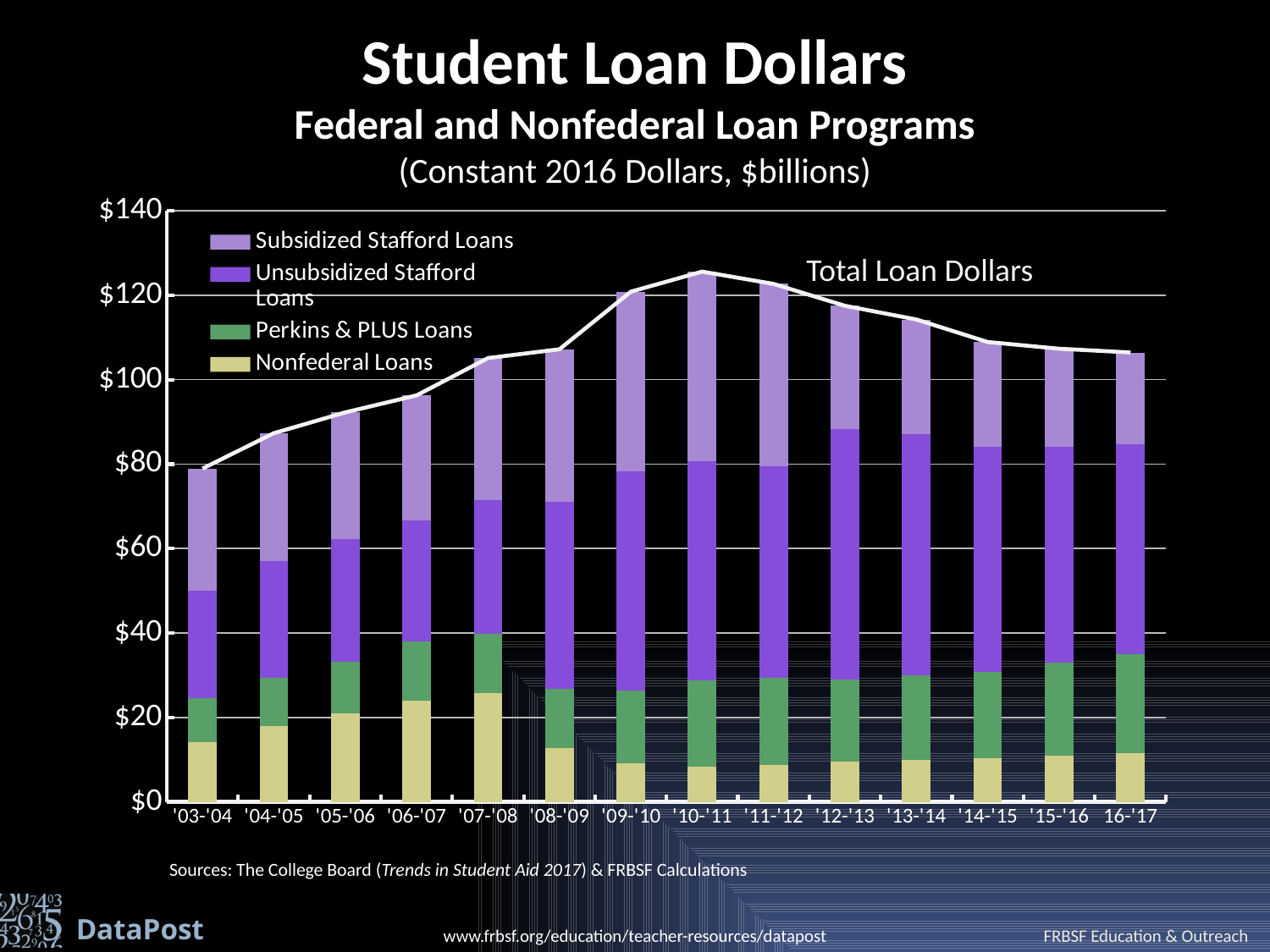
What kind of chart is shown on the slide? Stacked bar chart with a line Is the Total Loan Dollars value for '03-'04 greater or less than $100? less In which academic year is Total Loan Dollars highest? '10-'11 Is the Nonfederal Loans value for '07-'08 greater or less than $20? greater What units are the values on the chart expressed in, according to the subtitle? Constant 2016 Dollars, $billions Is the Nonfederal Loans value for '10-'11 greater or less than $20? less How many academic years are shown on the x axis? 14 Which is larger, Total Loan Dollars in '10-'11 or in '16-'17? '10-'11 Do Total Loan Dollars rise or fall from '10-'11 to '16-'17? fall In which academic year is Total Loan Dollars lowest? '03-'04 How many series does the legend list? 4